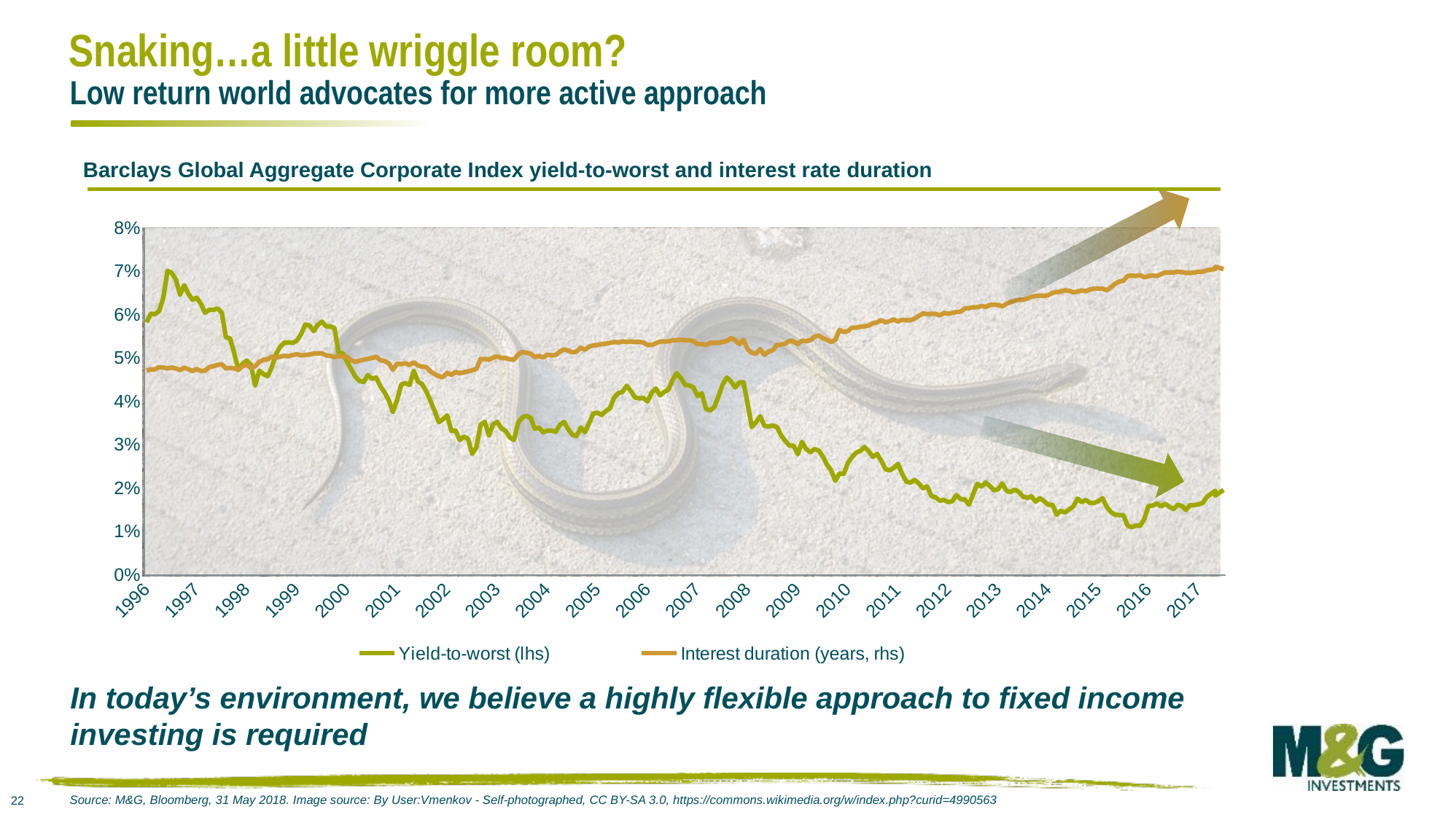
How many year labels are shown on the x axis? 22 Does the Interest duration series rise or fall overall from 1996 to 2017? rise Is the Yield-to-worst value at the start of 1996 greater or less than 5%? greater Is the Yield-to-worst value in 1997 greater or less than 5%? greater What is the title of the chart? Barclays Global Aggregate Corporate Index yield-to-worst and interest rate duration In which year does the Yield-to-worst series reach its highest point? 1997 What kind of chart is shown on the slide? line chart How many series does the chart's legend list? 2 Is the Yield-to-worst value in 2016 greater or less than 3%? less Does the Yield-to-worst series rise or fall overall from 1996 to 2017? fall In which year does the Yield-to-worst series reach its lowest point? 2016 Which two series are listed in the chart's legend? Yield-to-worst (lhs) and Interest duration (years, rhs)